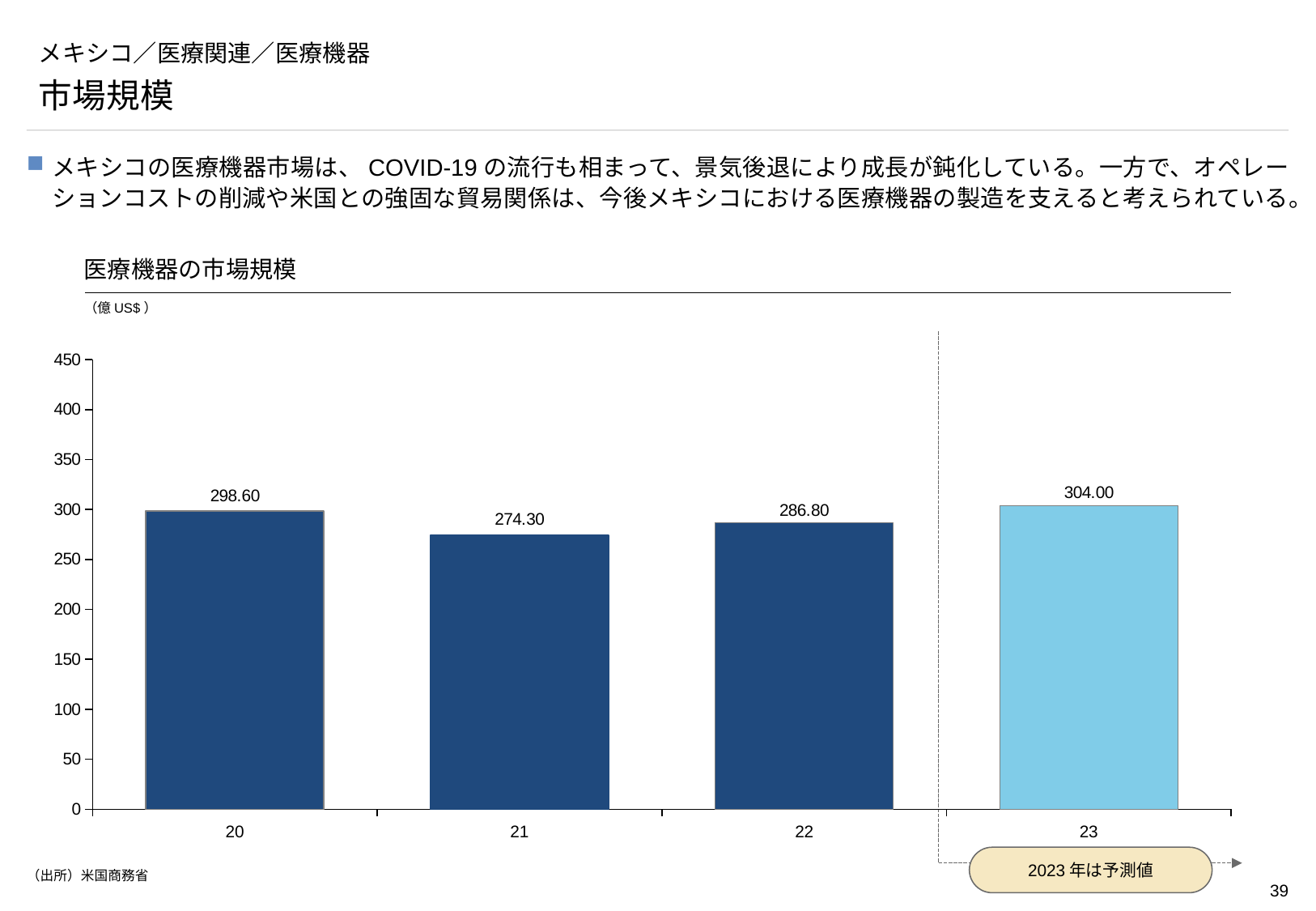
What kind of chart is shown on the slide? Bar chart What is the value for 20 in the 医療機器の市場規模 chart? 298.60 What is the difference between the values for 23 and 22? 17.20 What is the value for 21? 274.30 How many bars are shown in the chart? 4 What is the value for 22? 286.80 What is the difference between the values for 20 and 21? 24.30 Which year has the lowest value? 21 What unit is shown for the chart's values? 億 US$ Which year has the highest value? 23 Which is larger, the value for 20 or the value for 22? 20 What is the value for 23? 304.00